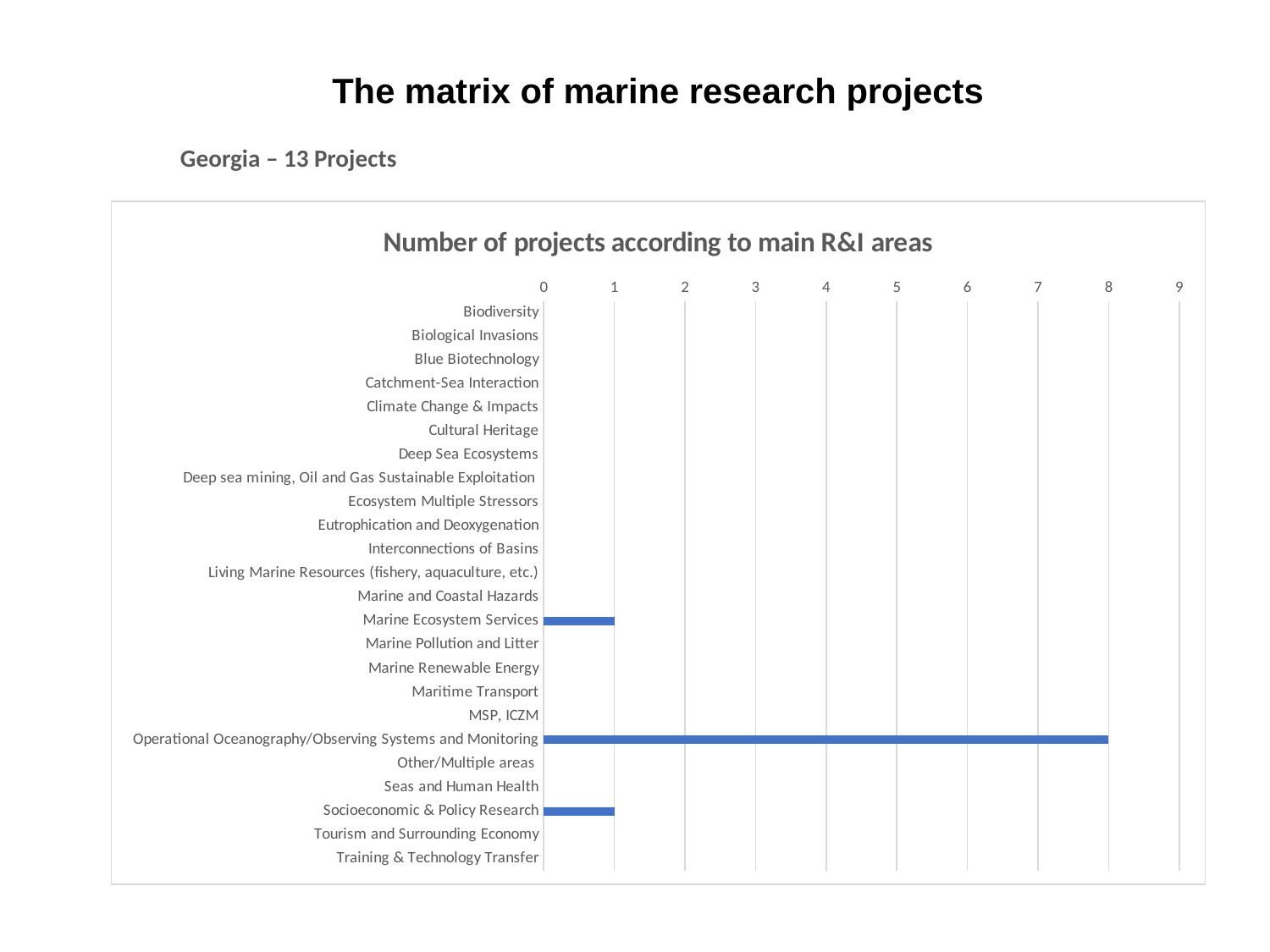
How many projects are shown for Marine Ecosystem Services? 1 How many projects are shown for Socioeconomic & Policy Research? 1 What is the highest value shown on the horizontal axis of the chart? 9 What is the difference in the number of projects between Operational Oceanography/Observing Systems and Monitoring and Socioeconomic & Policy Research? 7 Which R&I area has the highest number of projects? Operational Oceanography/Observing Systems and Monitoring How many projects are shown for Operational Oceanography/Observing Systems and Monitoring? 8 How many R&I areas have a visible bar (a non-zero number of projects)? 3 How many R&I area categories are listed on the chart's axis? 24 What is the title of the chart? Number of projects according to main R&I areas Which has more projects, Operational Oceanography/Observing Systems and Monitoring or Marine Ecosystem Services? Operational Oceanography/Observing Systems and Monitoring Is the value for Operational Oceanography/Observing Systems and Monitoring greater or less than 5? greater What type of chart is shown on the slide? Bar chart